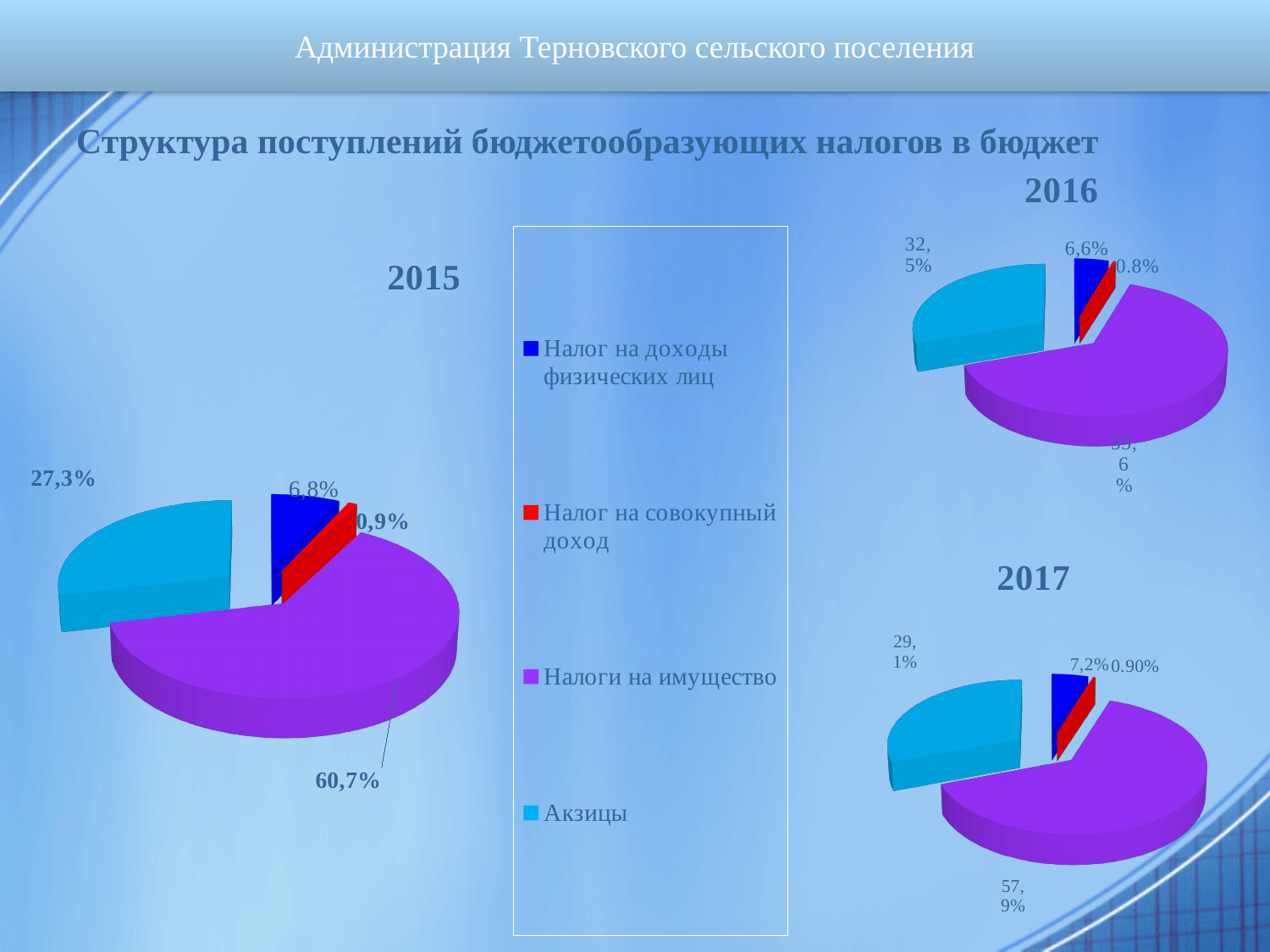
In the 2017 pie chart, what share is shown for Налоги на имущество? 57,9% How many series does the legend list? 4 In the 2016 pie chart, what share is shown for Налог на совокупный доход? 0.8% In the 2015 pie chart, what share is shown for Налог на доходы физических лиц? 6,8% In the 2017 pie chart, what share is shown for Налог на доходы физических лиц? 7,2% In the 2015 pie chart, what share is shown for Акзицы? 27,3% In the 2015 pie chart, what share is shown for Налоги на имущество? 60,7% In the 2016 pie chart, what share is shown for Акзицы? 32,5% What kind of chart is the 2016 chart? Pie chart In the 2015 pie chart, which category has the smallest slice? Налог на совокупный доход In the 2017 pie chart, which category has the largest slice? Налоги на имущество In the 2015 pie chart, what is the difference between the shares of Налоги на имущество and Акзицы? 33,4%